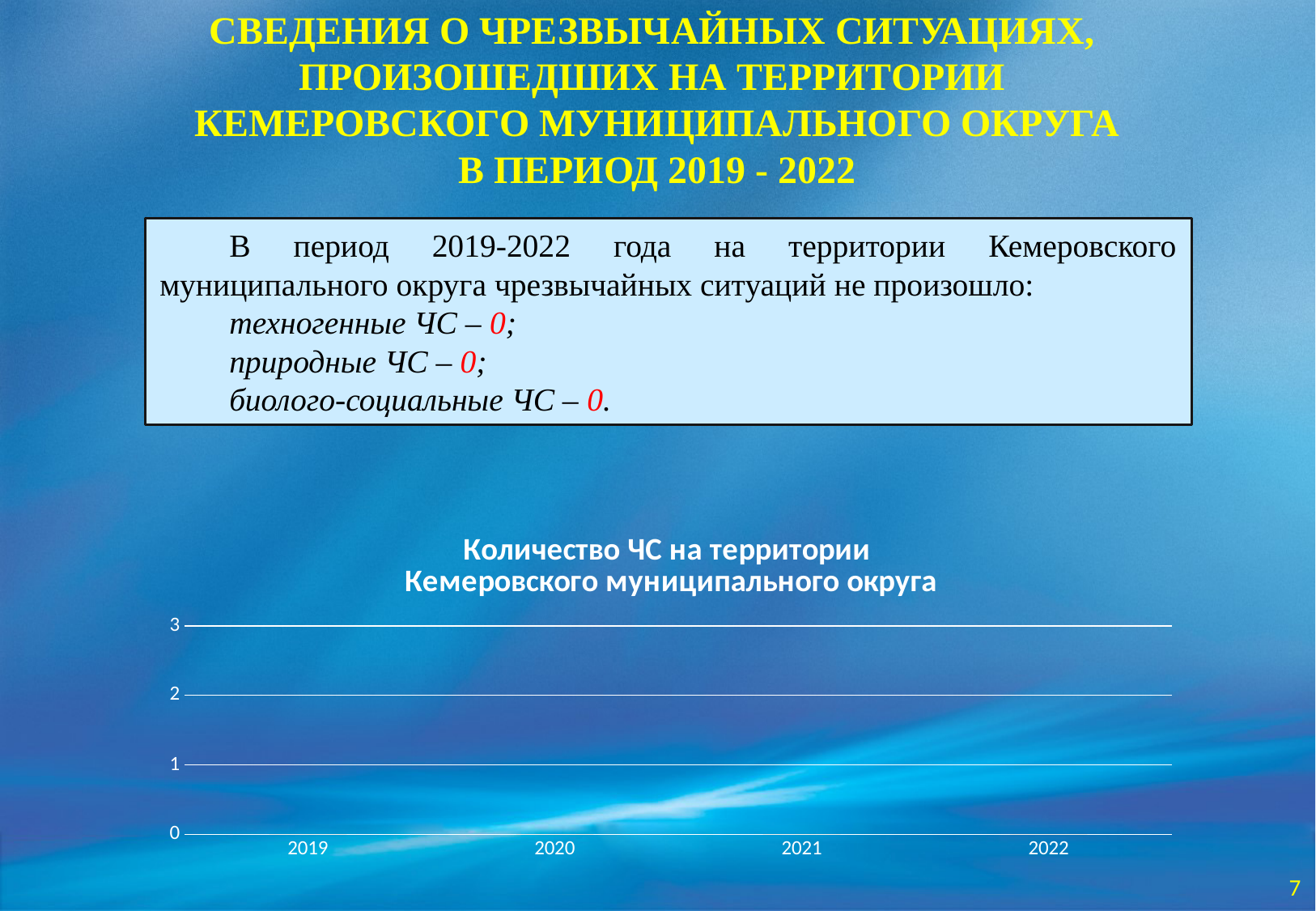
Which is the first year shown on the chart's x axis? 2019 How many year categories are shown on the x axis of the chart? 4 Is the value for 2019 on the chart greater or less than 1? less What is the title of the chart? Количество ЧС на территории Кемеровского муниципального округа What is the highest tick value shown on the chart's vertical axis? 3 Is the value for 2022 on the chart greater or less than 1? less